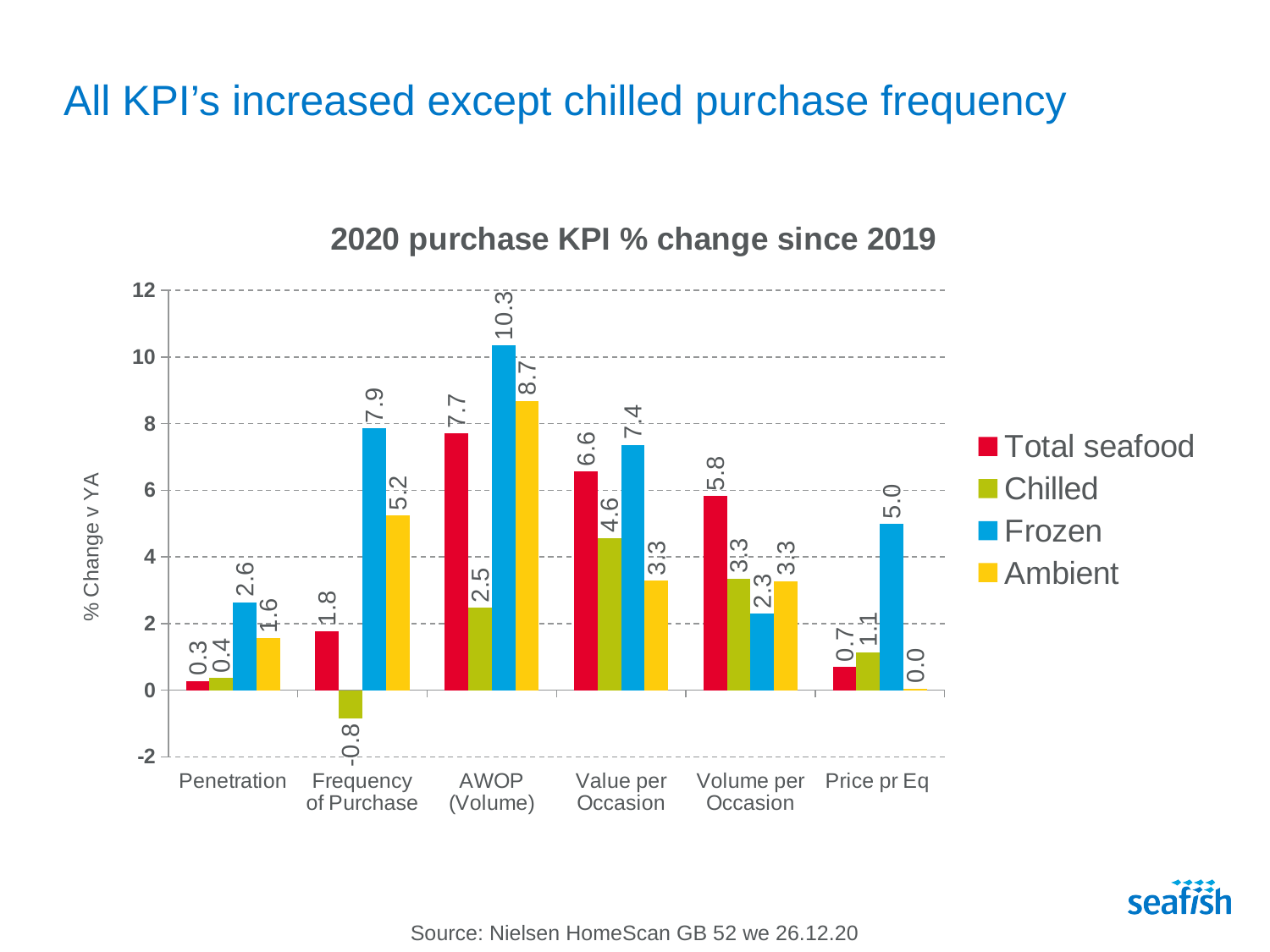
How many categories are shown on the x axis? 6 How many series does the legend list? 4 What is the Ambient value for Price pr Eq? 0.0 What kind of chart is shown on the slide? Bar chart For Value per Occasion, which is larger: the Total seafood value or the Frozen value? Frozen What is the Frozen value for AWOP (Volume)? 10.3 What is the Chilled value for Frequency of Purchase? -0.8 What is the Total seafood value for Volume per Occasion? 5.8 What is the title of the chart? 2020 purchase KPI % change since 2019 Which category has the lowest Chilled value? Frequency of Purchase What is the difference between the Frozen and Ambient values for AWOP (Volume)? 1.6 Which category has the highest Frozen value? AWOP (Volume)